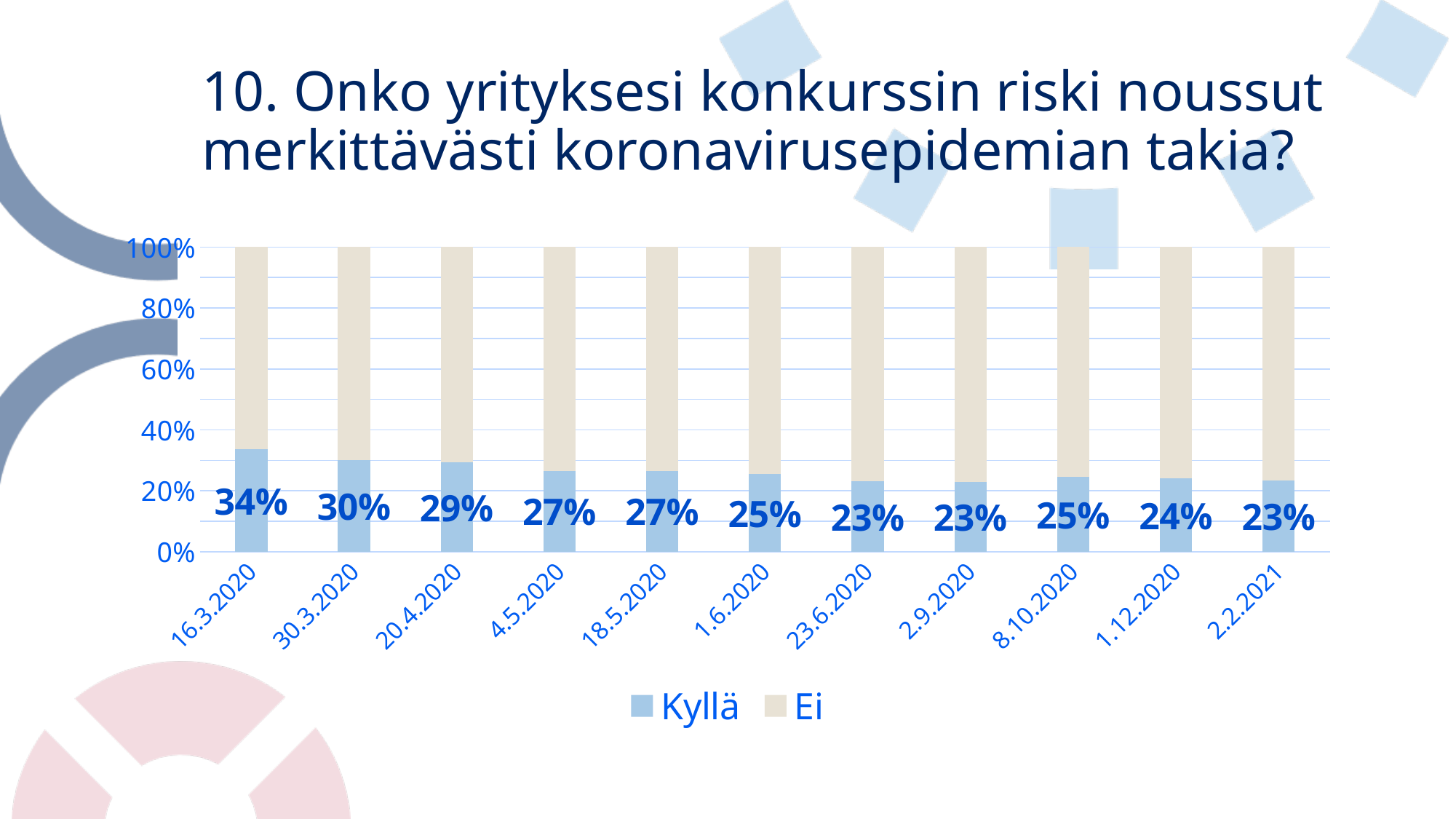
Which is larger, the Kyllä value for 1.6.2020 or for 1.12.2020? 1.6.2020 Do the Kyllä values generally rise or fall from 16.3.2020 to 2.2.2021? fall Is the Ei value for 16.3.2020 greater or less than 60%? greater How many dates are shown on the x axis? 11 What is the difference between the Kyllä values for 16.3.2020 and 30.3.2020? 4% What kind of chart is shown on the slide? stacked bar chart What is the Kyllä value for 8.10.2020? 25% What is the Kyllä value for 16.3.2020? 34% Which date has the highest Kyllä value? 16.3.2020 What are the two legend entries of the chart? Kyllä and Ei What is the Kyllä value for 2.2.2021? 23% How many series does the legend list? 2